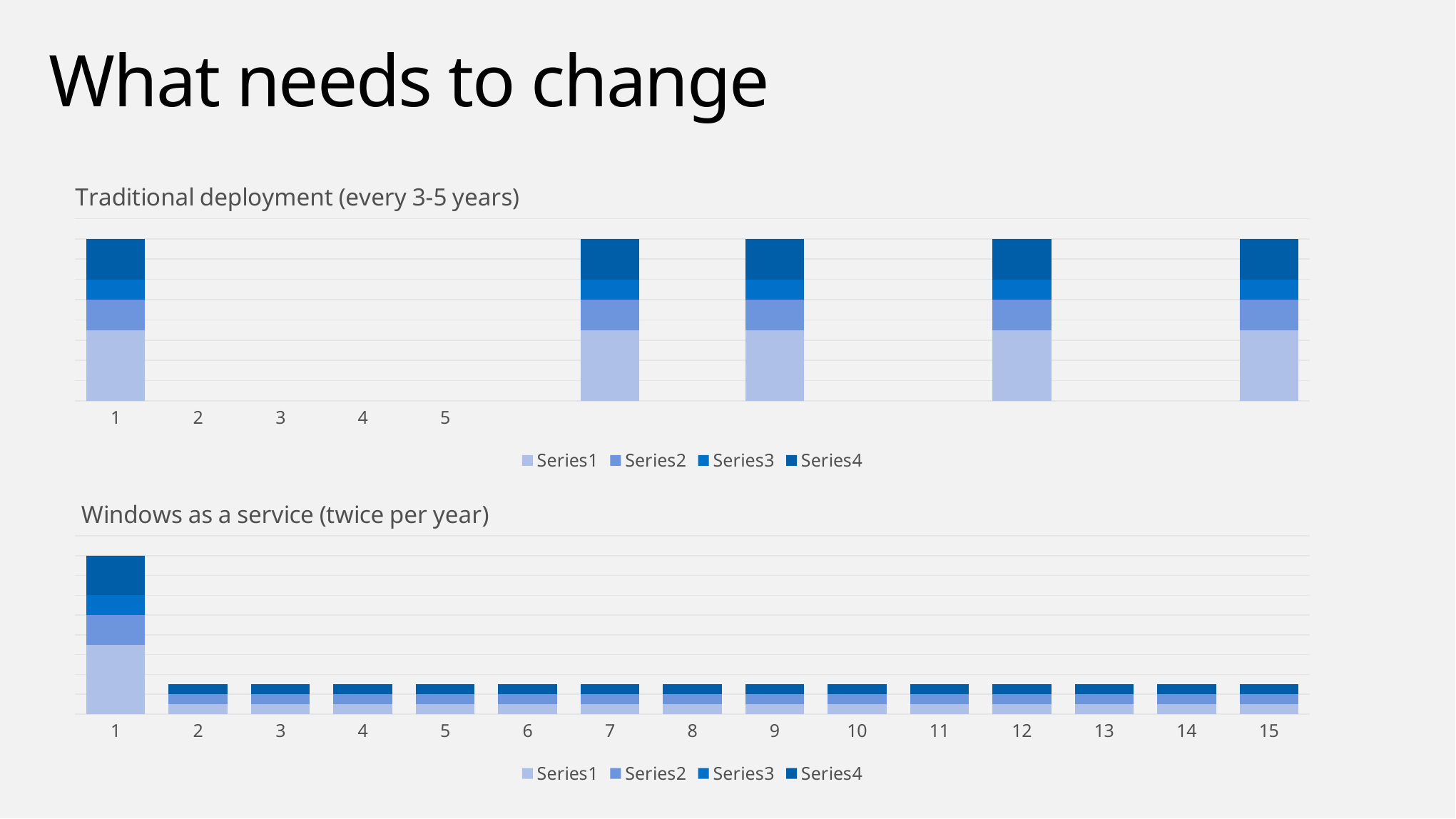
What kind of chart is the 'Traditional deployment (every 3-5 years)' chart? stacked bar chart What is the title of the top chart on the slide? Traditional deployment (every 3-5 years) How many categories are shown on the x axis of the 'Windows as a service (twice per year)' chart? 15 What kind of chart is the 'Windows as a service (twice per year)' chart? stacked bar chart How many series does the legend of the 'Windows as a service (twice per year)' chart list? 4 In the 'Windows as a service (twice per year)' chart, is the stacked bar for category 1 taller or shorter than the bar for category 2? taller How many bars are plotted in the 'Traditional deployment (every 3-5 years)' chart? 5 What are the legend entries of the bottom chart? Series1, Series2, Series3, Series4 In the 'Windows as a service (twice per year)' chart, is the bar for category 8 taller or shorter than the bar for category 1? shorter How many series does the legend of the 'Traditional deployment (every 3-5 years)' chart list? 4 In the 'Windows as a service (twice per year)' chart, which category has the tallest stacked bar? 1